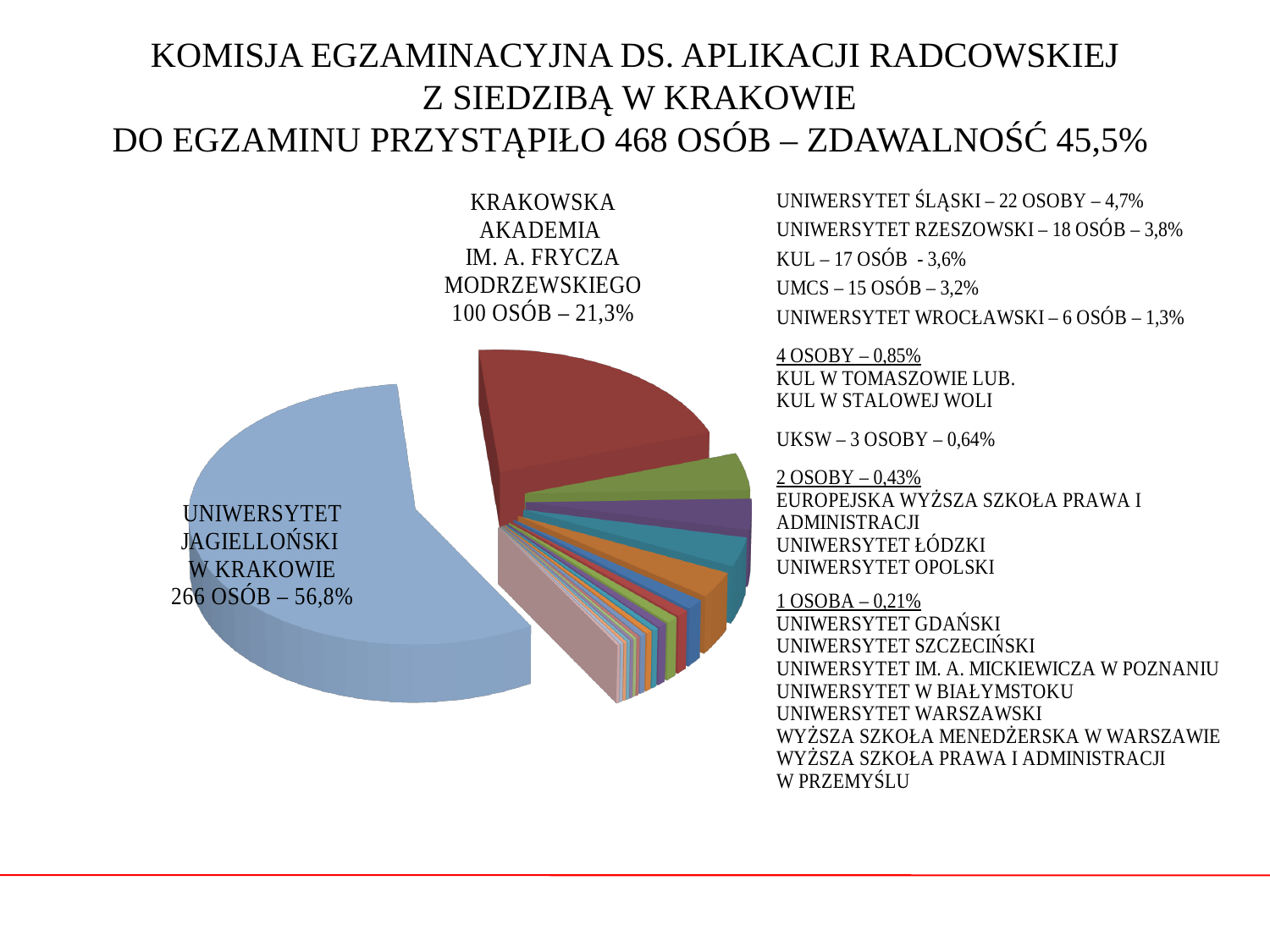
What kind of chart is shown on the slide? pie chart How many people from Uniwersytet Jagielloński w Krakowie took the exam? 266 What share of the pie does Uniwersytet Jagielloński w Krakowie represent? 56,8% How many people from Krakowska Akademia im. A. Frycza Modrzewskiego took the exam? 100 What is the difference in number of people between Uniwersytet Jagielloński w Krakowie and Krakowska Akademia im. A. Frycza Modrzewskiego? 166 How many people from UMCS took the exam? 15 How many people from UKSW took the exam? 3 Which institution has the largest slice of the pie? Uniwersytet Jagielloński w Krakowie What percentage is shown for Krakowska Akademia im. A. Frycza Modrzewskiego? 21,3% What percentage is shown for Uniwersytet Wrocławski? 1,3% Which has more people, Uniwersytet Śląski or Uniwersytet Rzeszowski? Uniwersytet Śląski What is the total number of people who took the exam according to the slide title? 468